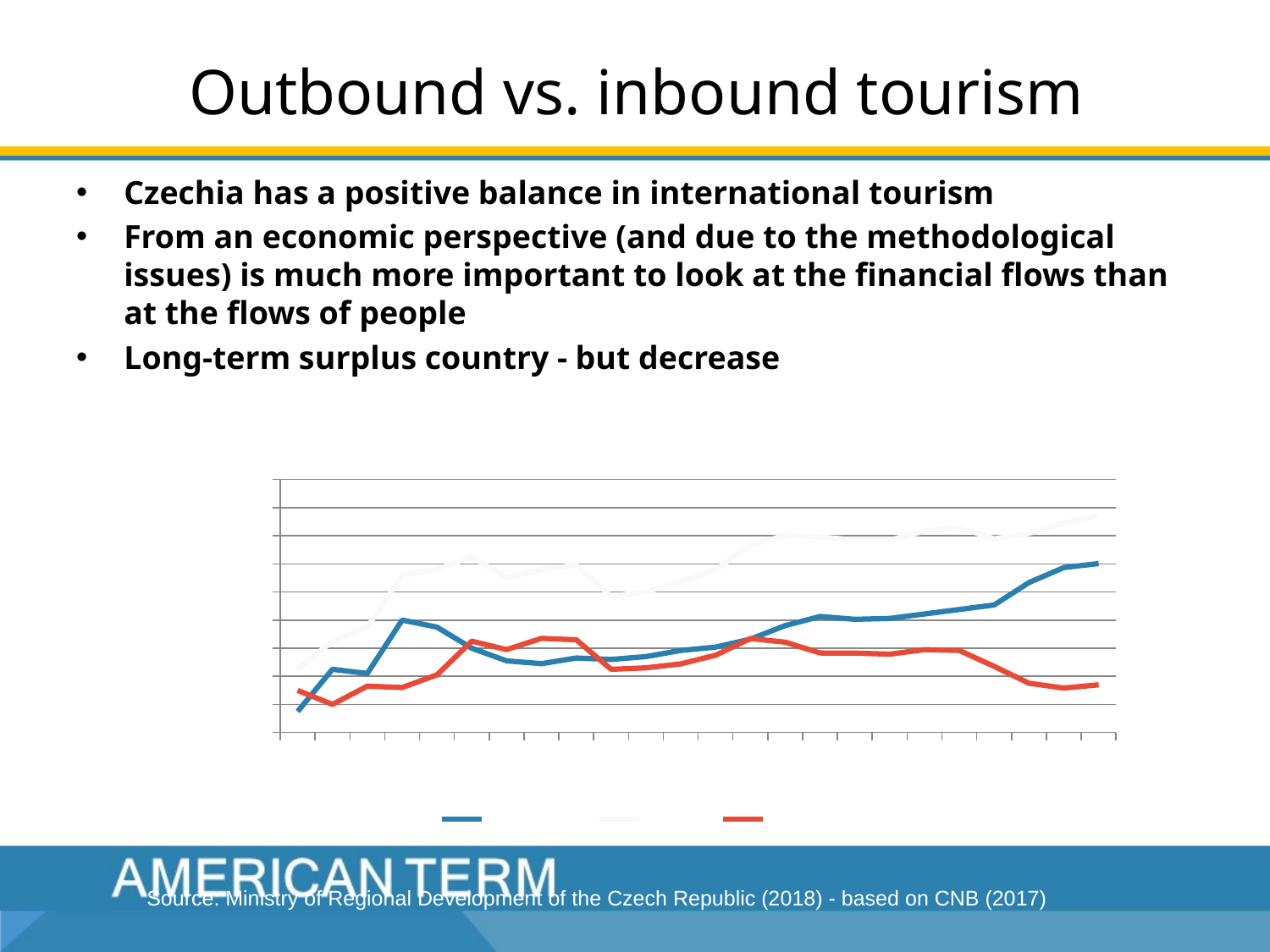
At the right end of the chart, which line is higher, the blue line or the red line? blue Does the blue line rise or fall overall from left to right? rise Does the red line rise or fall over the last few points on the right? fall How many series does the chart's legend list? 3 Which line is the lowest at the right end of the chart? the red line What colours are the three lines plotted on the chart? blue, white and red What kind of chart is shown on the slide? line chart